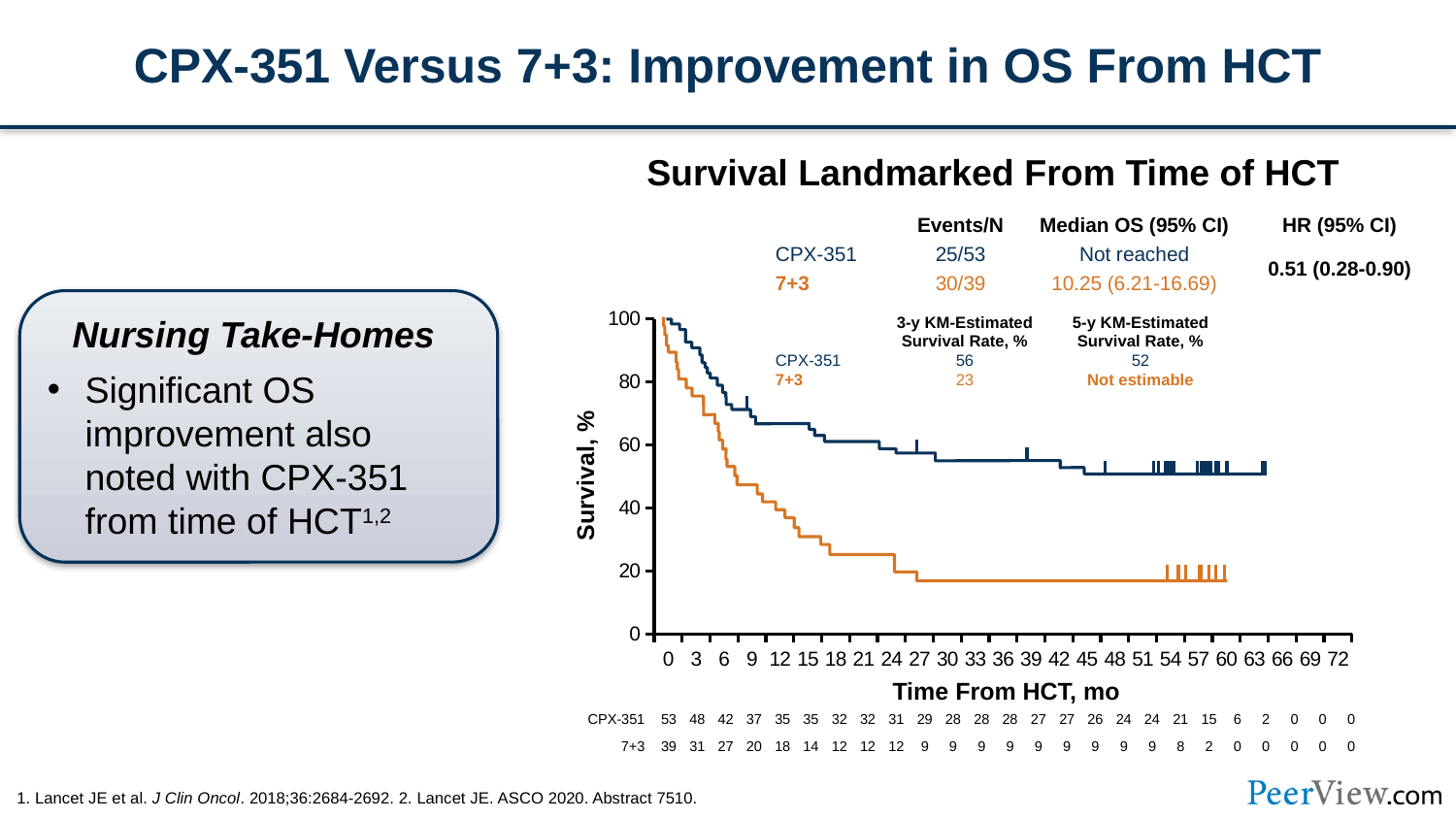
What is the hazard ratio (95% CI) shown on the chart? 0.51 (0.28-0.90) How many treatment groups (series) are plotted on the survival chart? 2 What is the 3-year KM-estimated survival rate for 7+3? 23 How many patients were at risk in the CPX-351 group at 24 months? 31 What is the difference between the 3-year KM-estimated survival rates of CPX-351 and 7+3? 33 Is the survival value for the 7+3 curve at 36 months greater or less than 40? less What is the 5-year KM-estimated survival rate for 7+3? Not estimable Which group has the higher survival curve over time, CPX-351 or 7+3? CPX-351 What kind of chart is shown on the slide? Line chart (Kaplan-Meier survival curve) What is the 3-year KM-estimated survival rate for CPX-351? 56 What is the label of the x axis? Time From HCT, mo What is the median OS (95% CI) for the 7+3 group? 10.25 (6.21-16.69)